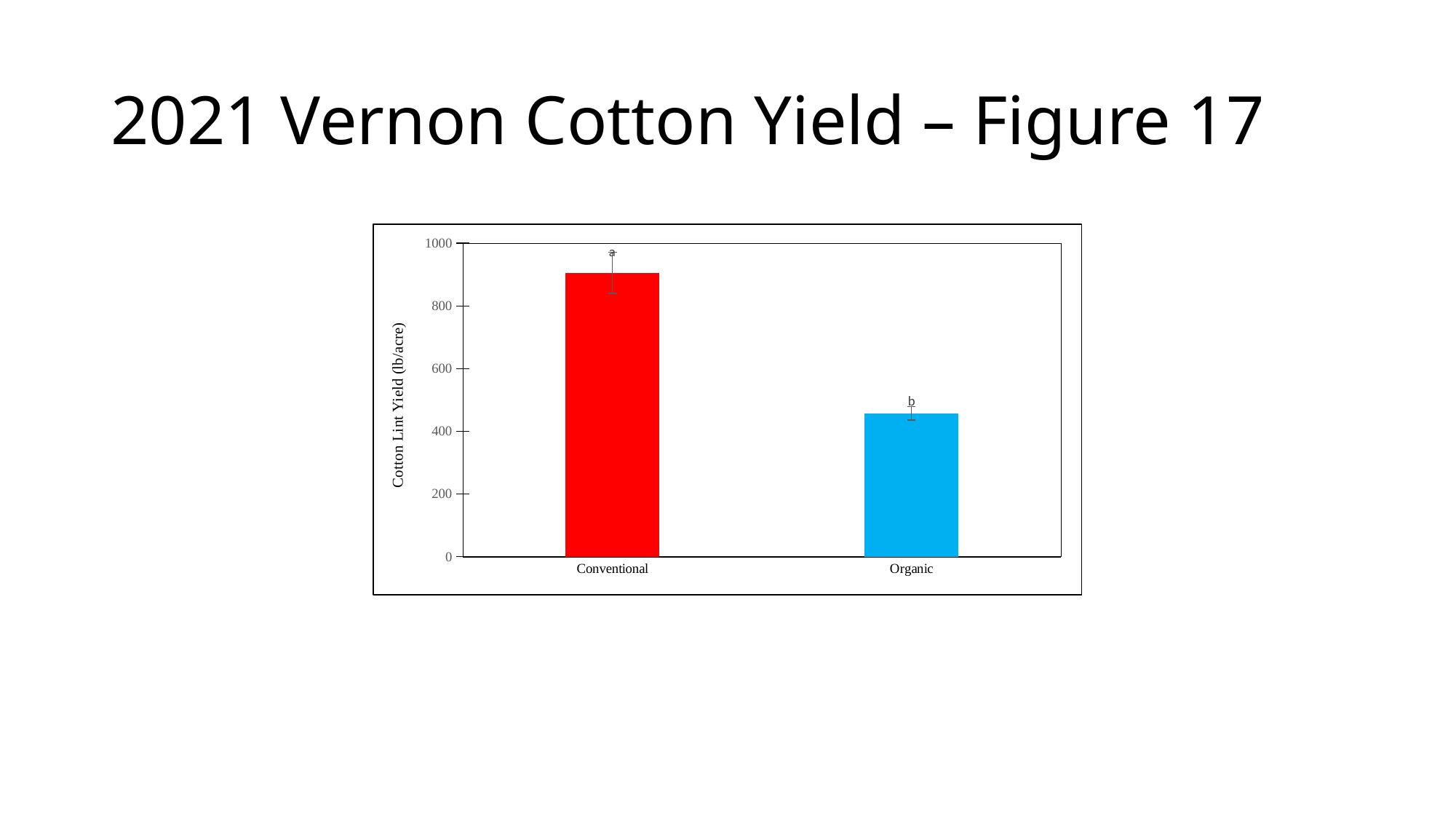
Which category has the highest cotton lint yield? Conventional Is the value for Conventional greater or less than 1000? less What is the label of the y axis? Cotton Lint Yield (lb/acre) What kind of chart is shown on the slide? bar chart Is the value for Organic greater or less than 400? greater How many categories are plotted on the x axis? 2 Is the value for Organic greater or less than 600? less What colour is the bar for Organic? blue Do the values rise or fall from Conventional to Organic along the x axis? fall Which has a larger cotton lint yield, Conventional or Organic? Conventional Which category has the lowest cotton lint yield? Organic